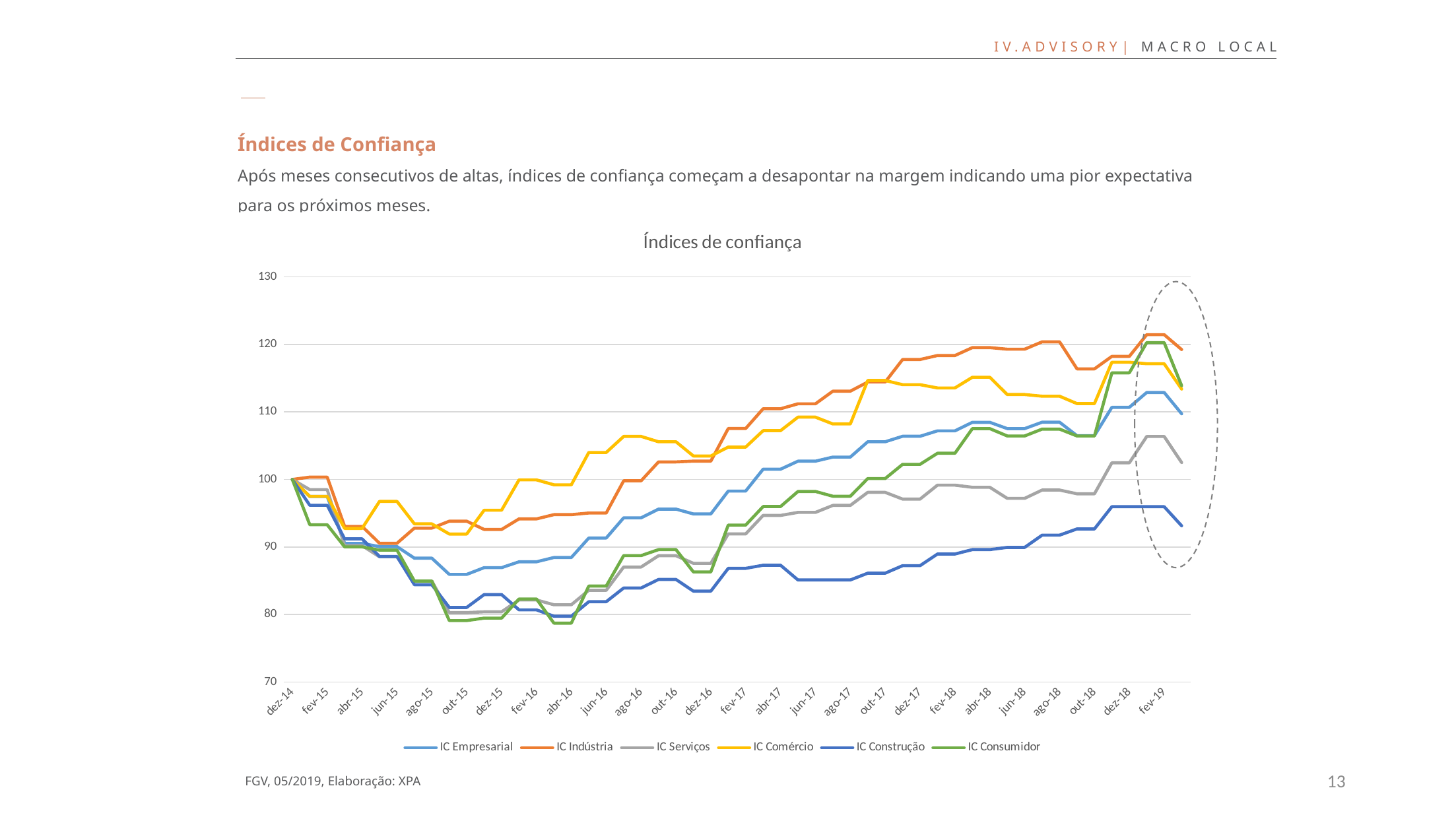
Is the value for IC Construção at fev-19 greater or less than 100? less Which series has the lowest value at jun-17? IC Construção Is the value for IC Indústria at fev-19 greater or less than 110? greater Does IC Indústria rise or fall between dez-16 and out-17? rise At out-17, which is larger: IC Comércio or IC Serviços? IC Comércio How many series does the legend of the chart list? 6 Which series has the lowest value at fev-19? IC Construção Is the value for IC Serviços at abr-16 greater or less than 90? less What is the value of IC Indústria at dez-14? 100 What is the title of the chart? Índices de confiança What kind of chart is shown on the slide? line chart What colour is the IC Comércio line in the chart? yellow